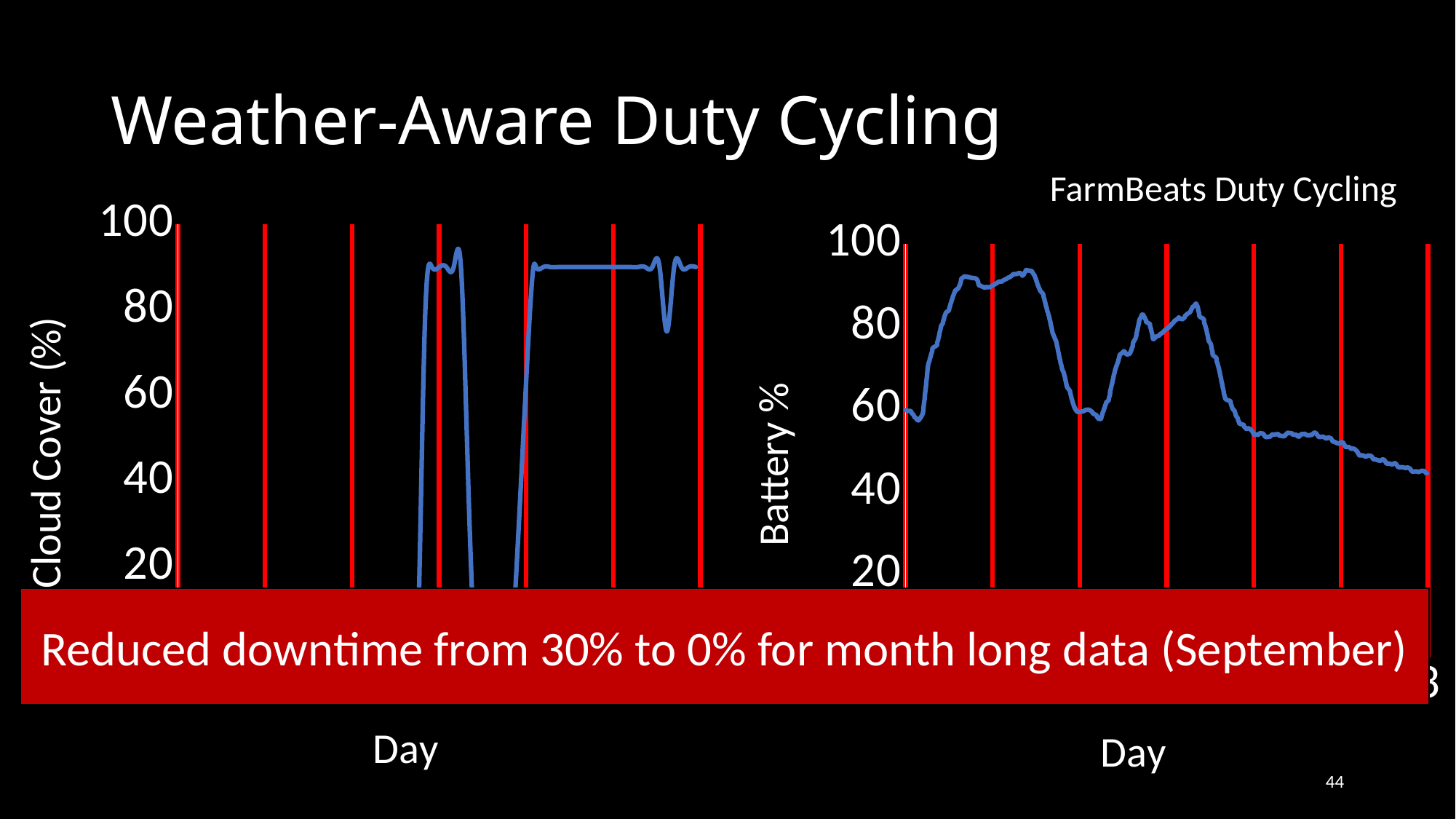
In the left chart (Cloud Cover), is the highest cloud cover value greater or less than 80? greater In the right chart (FarmBeats Duty Cycling), is the battery % at the start of the line greater or less than 80? less What kind of chart is the right chart (FarmBeats Duty Cycling)? line chart In the right chart (FarmBeats Duty Cycling), is the highest battery % reached greater or less than 80? greater What is the title of the right chart? FarmBeats Duty Cycling What kind of chart is the left chart (Cloud Cover)? line chart In the right chart (FarmBeats Duty Cycling), does the battery % rise or fall over the final stretch of the line? fall What is the y-axis label of the left chart? Cloud Cover (%)